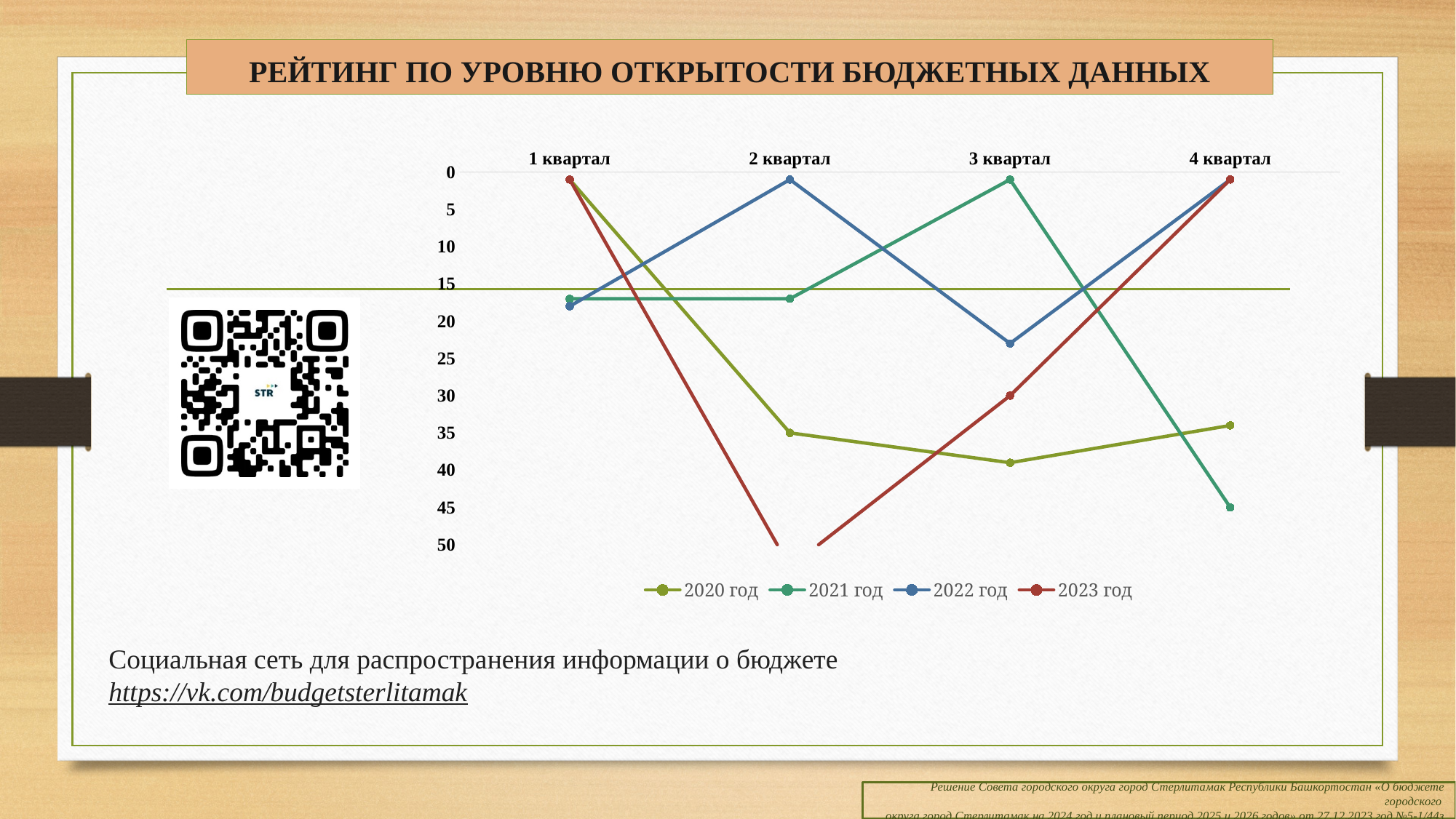
Is the value for 2022 год in 3 квартал greater or less than 20? greater What kind of chart is shown on the slide? line chart What is the title of the chart? РЕЙТИНГ ПО УРОВНЮ ОТКРЫТОСТИ БЮДЖЕТНЫХ ДАННЫХ How many series does the legend list? 4 Which series is drawn in red? 2023 год Which series has the largest numeric value in 4 квартал? 2021 год In 4 квартал, which series has the larger numeric value: 2020 год or 2021 год? 2021 год Is the value for 2023 год in 3 квартал greater or less than 25? greater Is the value for 2021 год in 4 квартал greater or less than 40? greater How many categories are shown on the x axis? 4